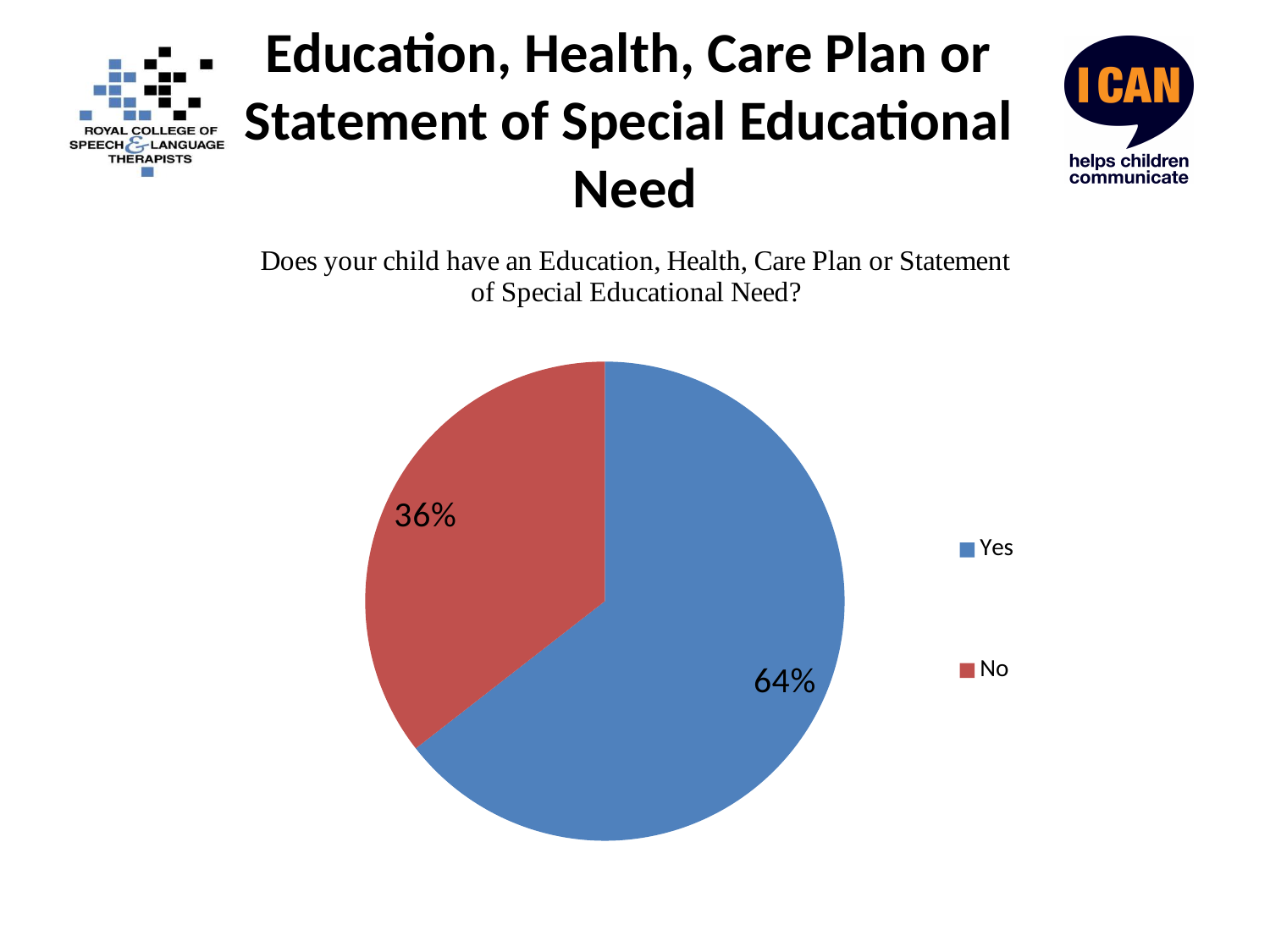
Which response has the largest share of the pie? Yes What colour is the Yes slice? blue How many slices does the pie chart have? 2 What is the difference in percentage points between the Yes and No slices? 28 What kind of chart is shown on the slide? pie chart How many entries does the legend list? 2 Which response has the smallest share of the pie? No Which slice is larger, Yes or No? Yes What question is the pie chart answering, as shown above the chart? Does your child have an Education, Health, Care Plan or Statement of Special Educational Need? What share of the pie does the No slice represent? 36% What percentage of respondents answered Yes? 64% What percentage of respondents answered No? 36%